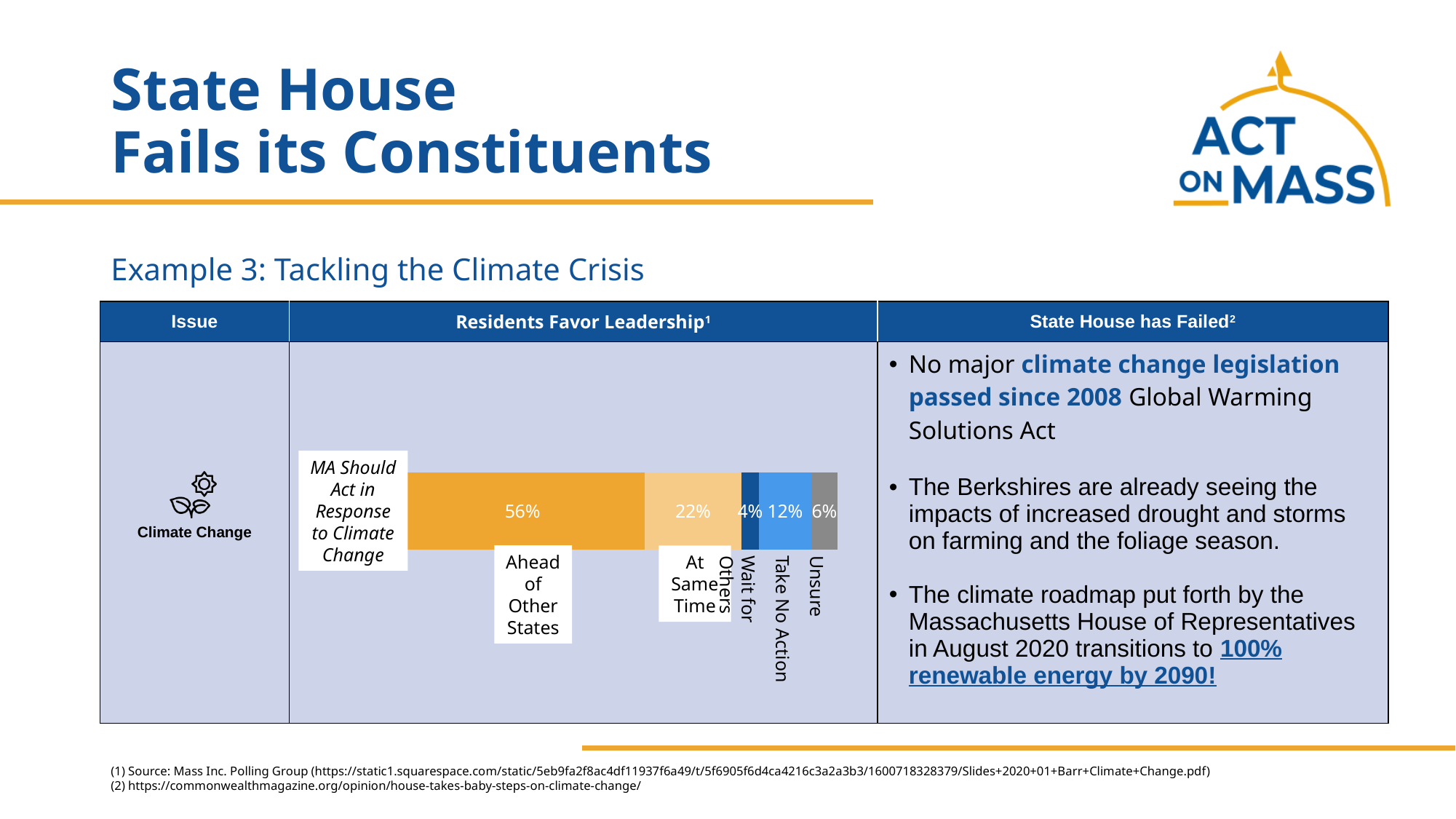
Which response has the largest share in the bar? Ahead of Other States What is the difference between the 'Ahead of Other States' share and the 'At Same Time' share? 34% What percentage of residents are unsure? 6% Which is larger: the 'Take No Action' share or the 'Unsure' share? Take No Action What kind of chart is shown in the 'Residents Favor Leadership' column? Stacked bar chart What is the label on the left of the bar describing what the chart measures? MA Should Act in Response to Climate Change How many segments make up the stacked bar? 5 What percentage of residents say MA should take no action? 12% What percentage of residents say MA should act at the same time as other states? 22% What percentage of residents say MA should wait for others? 4% Which response has the smallest share in the bar? Wait for Others What percentage of residents say MA should act ahead of other states? 56%